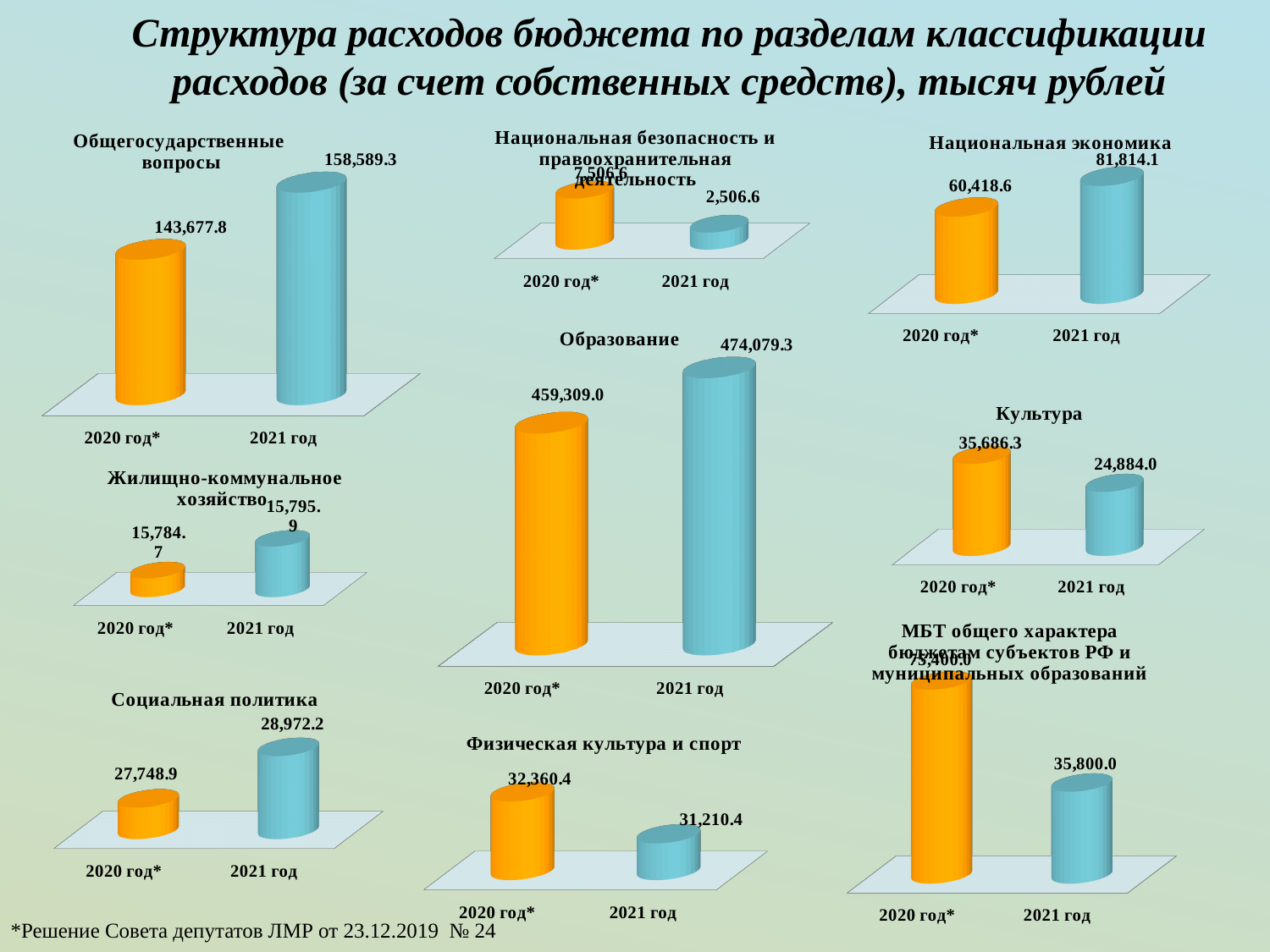
In the "Национальная экономика" chart, what is the value for 2021 год? 81,814.1 In the "МБТ общего характера бюджетам субъектов РФ и муниципальных образований" chart, what is the value for 2021 год? 35,800.0 In the "Физическая культура и спорт" chart, which year has the lower value? 2021 год In the "Образование" chart, which year has the higher value? 2021 год In the "Культура" chart, what is the value for 2021 год? 24,884.0 In the "Социальная политика" chart, what is the value for 2021 год? 28,972.2 In the "Национальная экономика" chart, what is the difference between the 2021 год and 2020 год* values? 21,395.5 In the "Образование" chart, what is the value for 2020 год*? 459,309.0 In the "Общегосударственные вопросы" chart, what is the value for 2020 год*? 143,677.8 What kind of chart is used for "Социальная политика"? bar chart In the "Общегосударственные вопросы" chart, what is the value for 2021 год? 158,589.3 In the "Культура" chart, do the values rise or fall from 2020 год* to 2021 год? fall